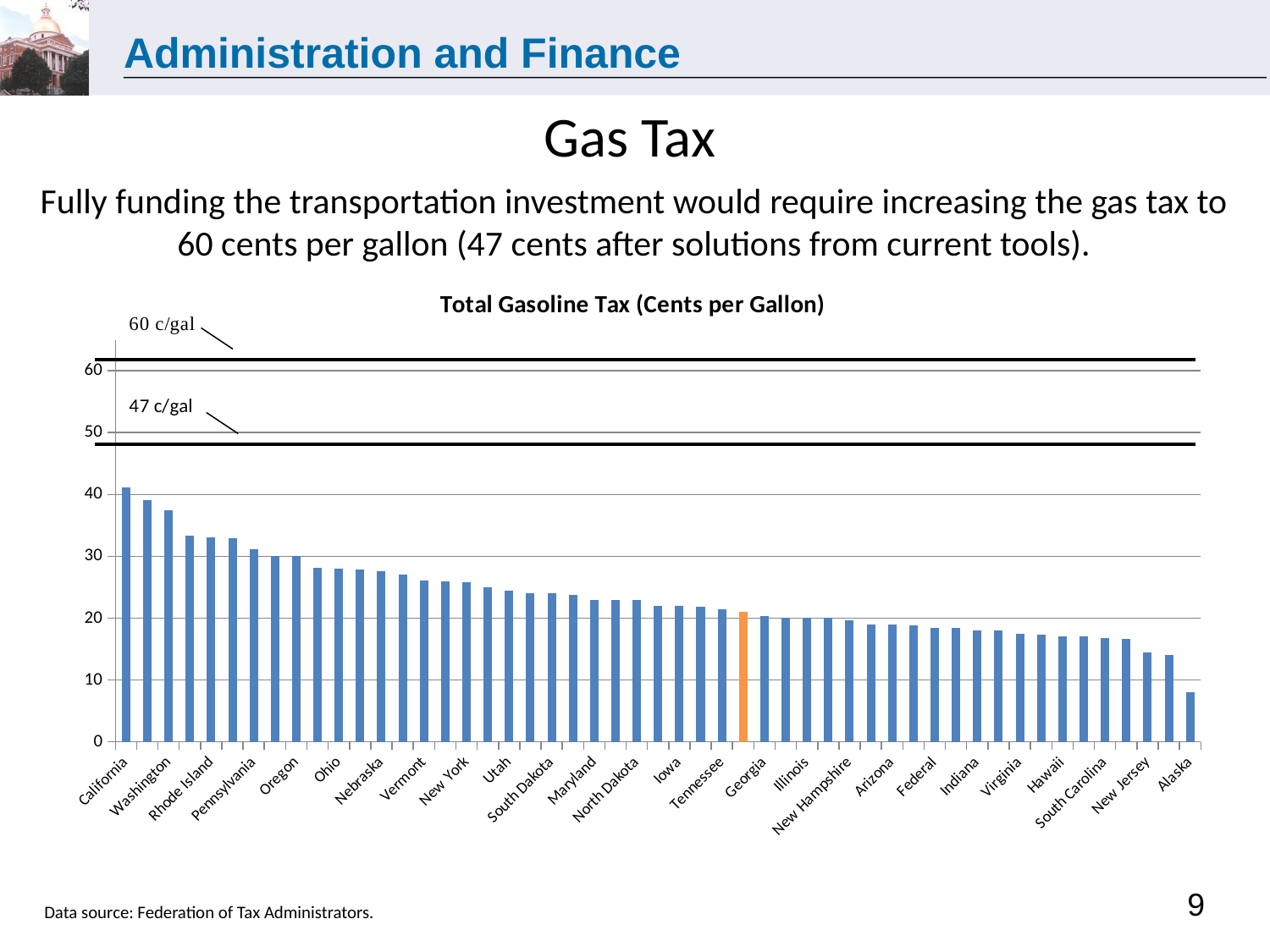
What kind of chart is shown on the slide? bar chart Which state has the lowest total gasoline tax in the chart? Alaska Do the bar values rise or fall moving from left to right along the x axis? fall Is the value for Ohio greater or less than 30? less Is the value for Washington greater or less than 30? greater Which has the larger total gasoline tax, Vermont or New Jersey? Vermont Is the value for Alaska greater or less than 10? less What two reference levels are marked by the horizontal lines drawn across the chart? 60 c/gal and 47 c/gal What is the title of the chart? Total Gasoline Tax (Cents per Gallon) Which state has the highest total gasoline tax in the chart? California